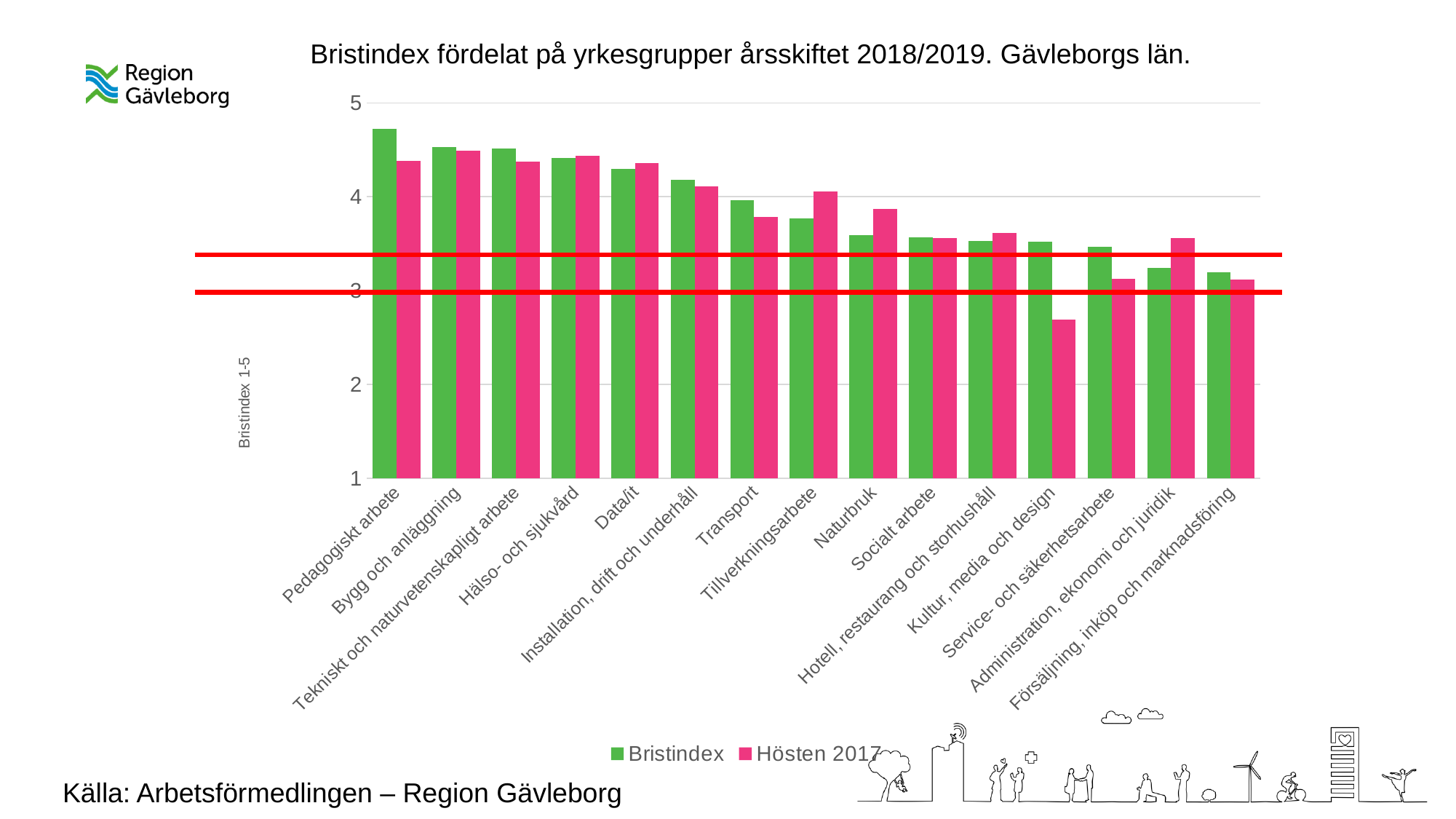
Is the Bristindex value for Pedagogiskt arbete greater or less than 4? greater Do the Bristindex values generally rise or fall from left to right along the x axis? Fall Is the Hösten 2017 value for Kultur, media och design greater or less than 3? less For Tillverkningsarbete, which series has the larger value, Bristindex or Hösten 2017? Hösten 2017 Which occupational group has the highest Bristindex value? Pedagogiskt arbete What kind of chart is shown on the slide? Bar chart Which occupational group has the lowest Hösten 2017 value? Kultur, media och design Is the Bristindex value for Naturbruk greater or less than 4? less Which occupational group has the lowest Bristindex value? Försäljning, inköp och marknadsföring What colour are the Hösten 2017 bars? Pink How many occupational groups (categories) are shown on the x axis? 15 How many series does the legend list? 2